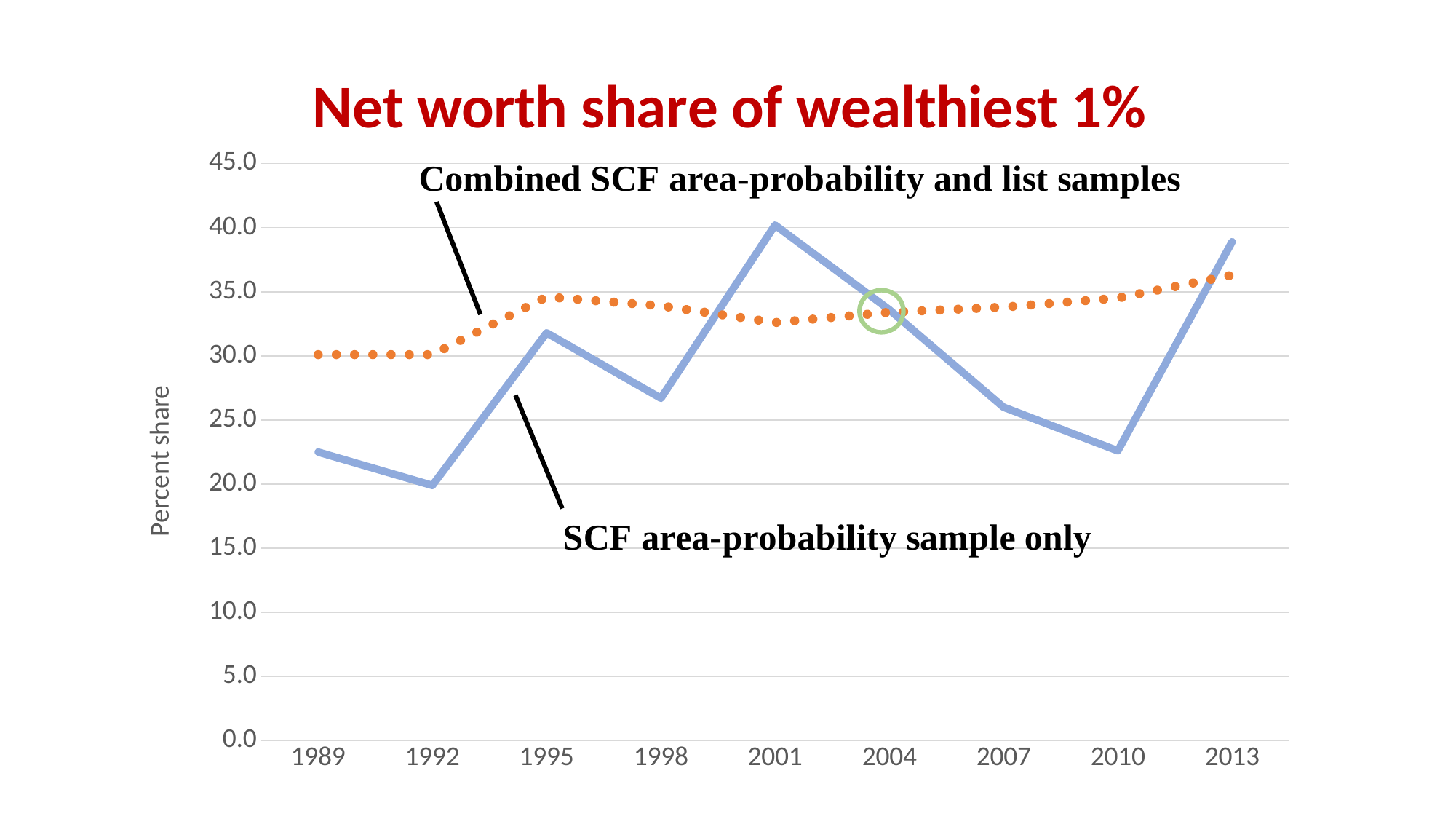
Is the value for the 'SCF area-probability sample only' series in 2001 greater or less than 35.0? greater Is the value for the 'Combined SCF area-probability and list samples' series in 1989 greater or less than 25.0? greater What is the title of the chart? Net worth share of wealthiest 1% Is the value for the 'SCF area-probability sample only' series in 1992 greater or less than 25.0? less How many years are plotted along the x axis? 9 In 2010, which series has the higher value: 'SCF area-probability sample only' or 'Combined SCF area-probability and list samples'? Combined SCF area-probability and list samples In which year does the 'Combined SCF area-probability and list samples' series reach its highest value? 2013 What kind of chart is shown on the slide? line chart How many data series are plotted on the chart? 2 In 2001, which series has the higher value: 'SCF area-probability sample only' or 'Combined SCF area-probability and list samples'? SCF area-probability sample only What is the label on the vertical axis? Percent share In which year does the 'SCF area-probability sample only' series reach its lowest value? 1992